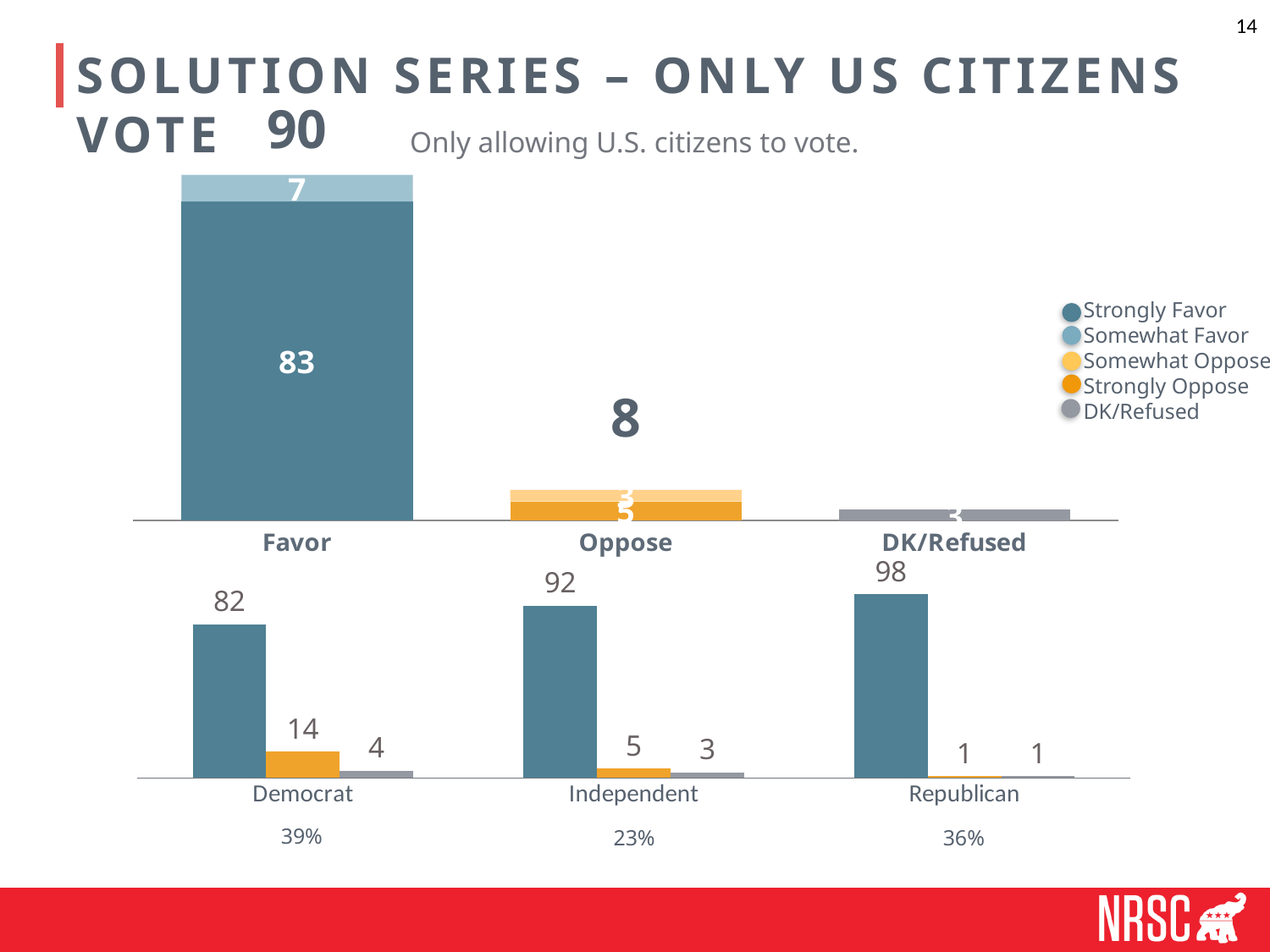
In the bottom chart by party, which has the larger Strongly Oppose value, Democrat or Independent? Democrat In the top stacked bar chart, what is the Strongly Favor value in the Favor bar? 83 In the top stacked bar chart, what is the total of the Favor bar? 90 In the bottom chart by party, what is the difference between the Strongly Favor values for Republican and Democrat? 16 In the bottom chart by party, what is the Strongly Oppose value for Democrat? 14 What kind of chart is the top chart on the slide? Stacked bar chart In the top stacked bar chart, how many series does the legend list? 5 In the bottom chart by party, which party has the highest Strongly Favor value? Republican In the bottom chart by party, how many party categories are shown? 3 In the bottom chart by party, what is the Strongly Favor value for Republican? 98 In the top stacked bar chart, what is the Somewhat Favor value in the Favor bar? 7 In the top stacked bar chart, what is the total of the Oppose bar? 8